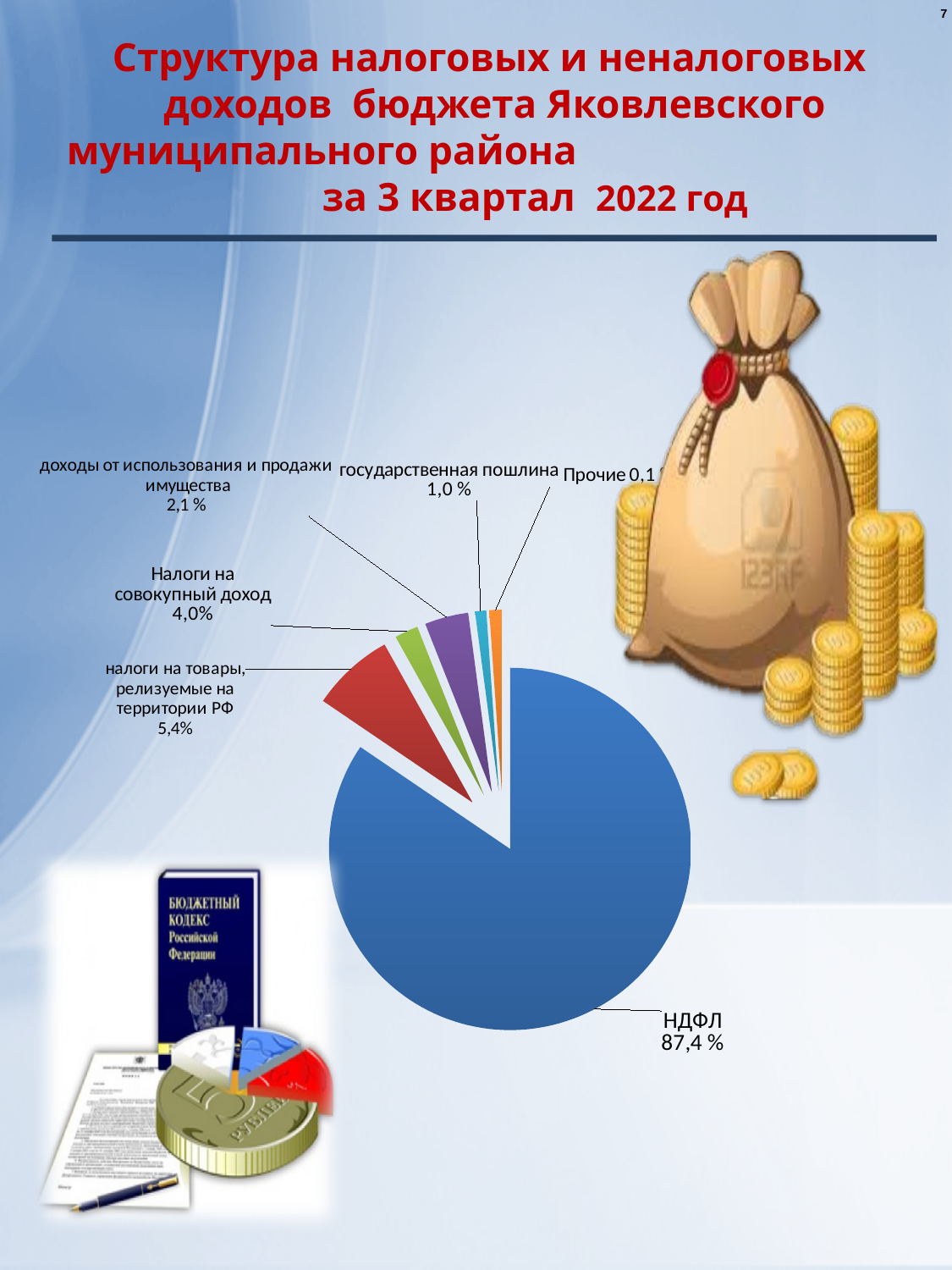
What is the value shown for доходы от использования и продажи имущества? 2,1 % How many slices does the pie chart have? 6 Which category has the largest slice of the pie? НДФЛ What is the value shown for государственная пошлина? 1,0 % What is the difference in percentage points between НДФЛ and налоги на товары, релизуемые на территории РФ? 82,0 What share of the pie does НДФЛ account for? 87,4 % Which category has the smallest slice of the pie? Прочие What is the value shown for налоги на товары, релизуемые на территории РФ? 5,4% What is the value shown for Налоги на совокупный доход? 4,0% Which is larger: налоги на товары, релизуемые на территории РФ or Налоги на совокупный доход? налоги на товары, релизуемые на территории РФ What kind of chart is shown on the slide? pie chart What colour is the НДФЛ slice of the pie? blue